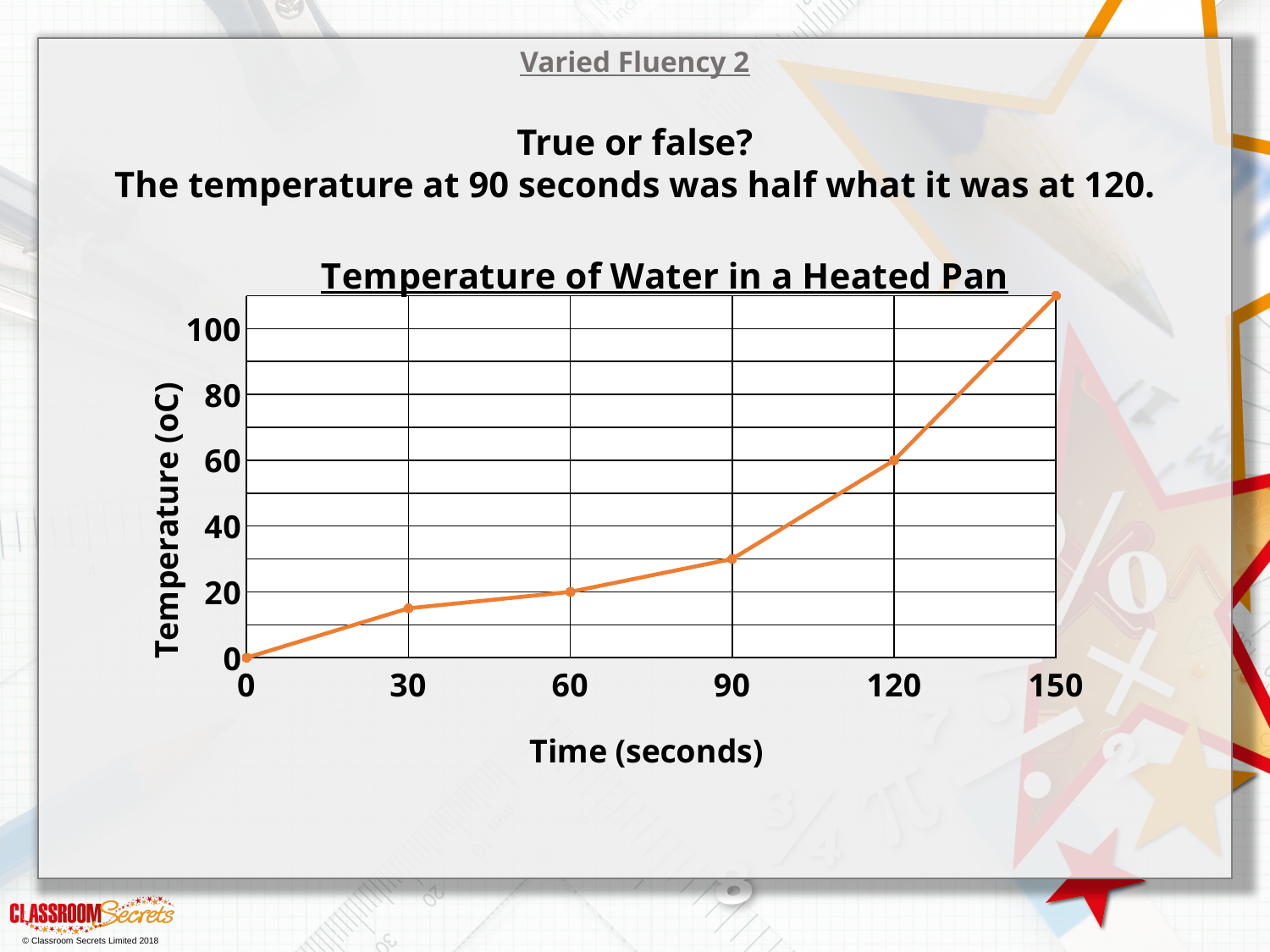
What is the label of the x axis? Time (seconds) What is the difference between the temperature at 120 seconds and the temperature at 60 seconds? 40 What is the title of the chart? Temperature of Water in a Heated Pan Does the temperature rise or fall as time increases? rise What is the temperature at 0 seconds? 0 What kind of chart is shown on the slide? line chart What is the temperature at 60 seconds? 20 How many data points are plotted on the line? 6 What is the temperature at 120 seconds? 60 At which time is the temperature highest? 150 Is the temperature at 90 seconds greater or less than 40? less Is the temperature at 150 seconds greater or less than 100? greater